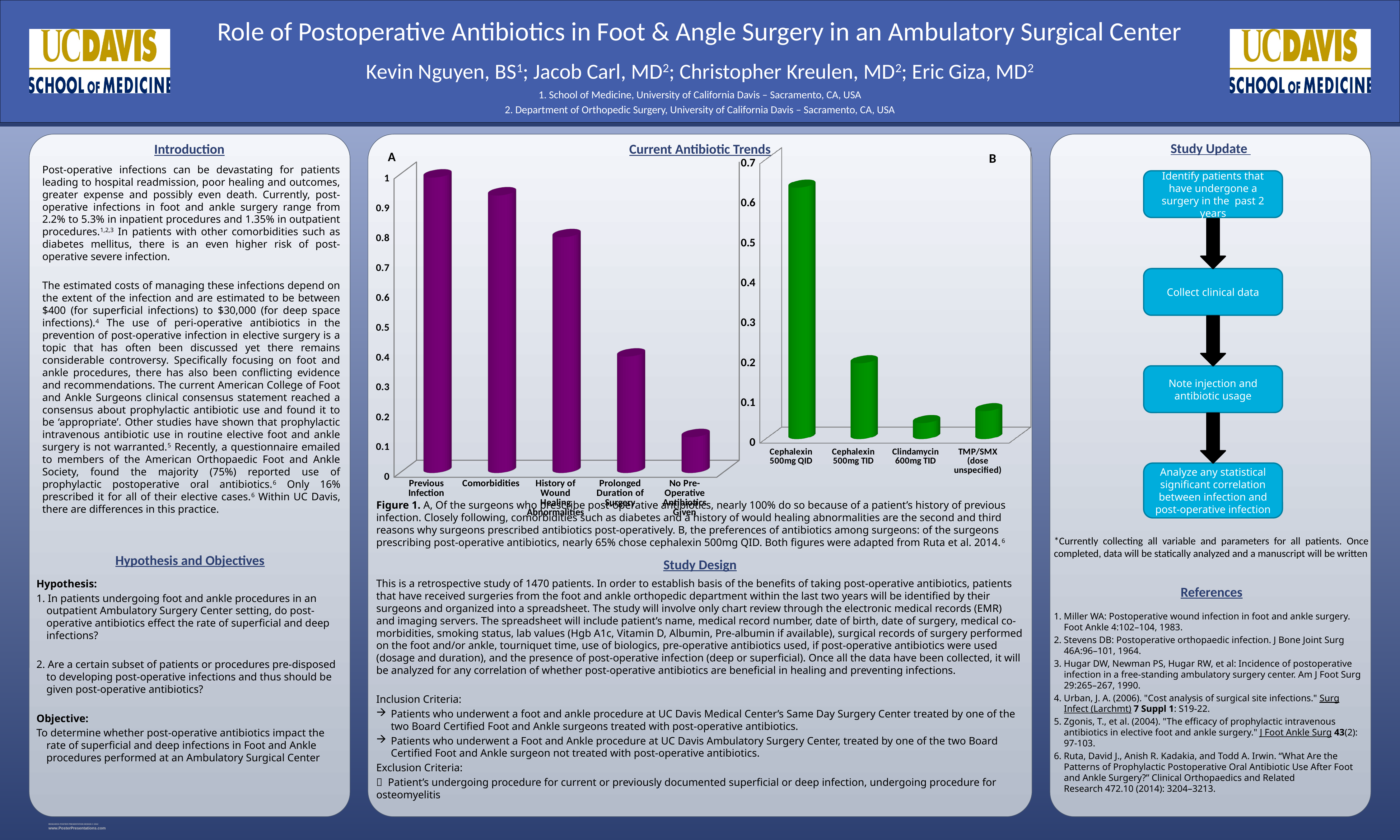
What kind of chart is chart A? bar chart In chart B, is the value for Cephalexin 500mg QID greater or less than 0.5? greater In chart B, is the value for Cephalexin 500mg TID greater or less than 0.3? less In chart A, is the value for History of Wound Healing Abnormalities greater or less than 0.7? greater In chart A, do the values rise or fall from left to right along the x axis? fall In chart A, which is larger: Comorbidities or Prolonged Duration of Surgery? Comorbidities In chart A of Current Antibiotic Trends, which category has the lowest value? No Pre-Operative Antibiotics Given How many categories are plotted in chart A? 5 In chart B of Current Antibiotic Trends, which antibiotic has the highest value? Cephalexin 500mg QID How many antibiotics are plotted in chart B? 4 What is the title shown above the two charts? Current Antibiotic Trends